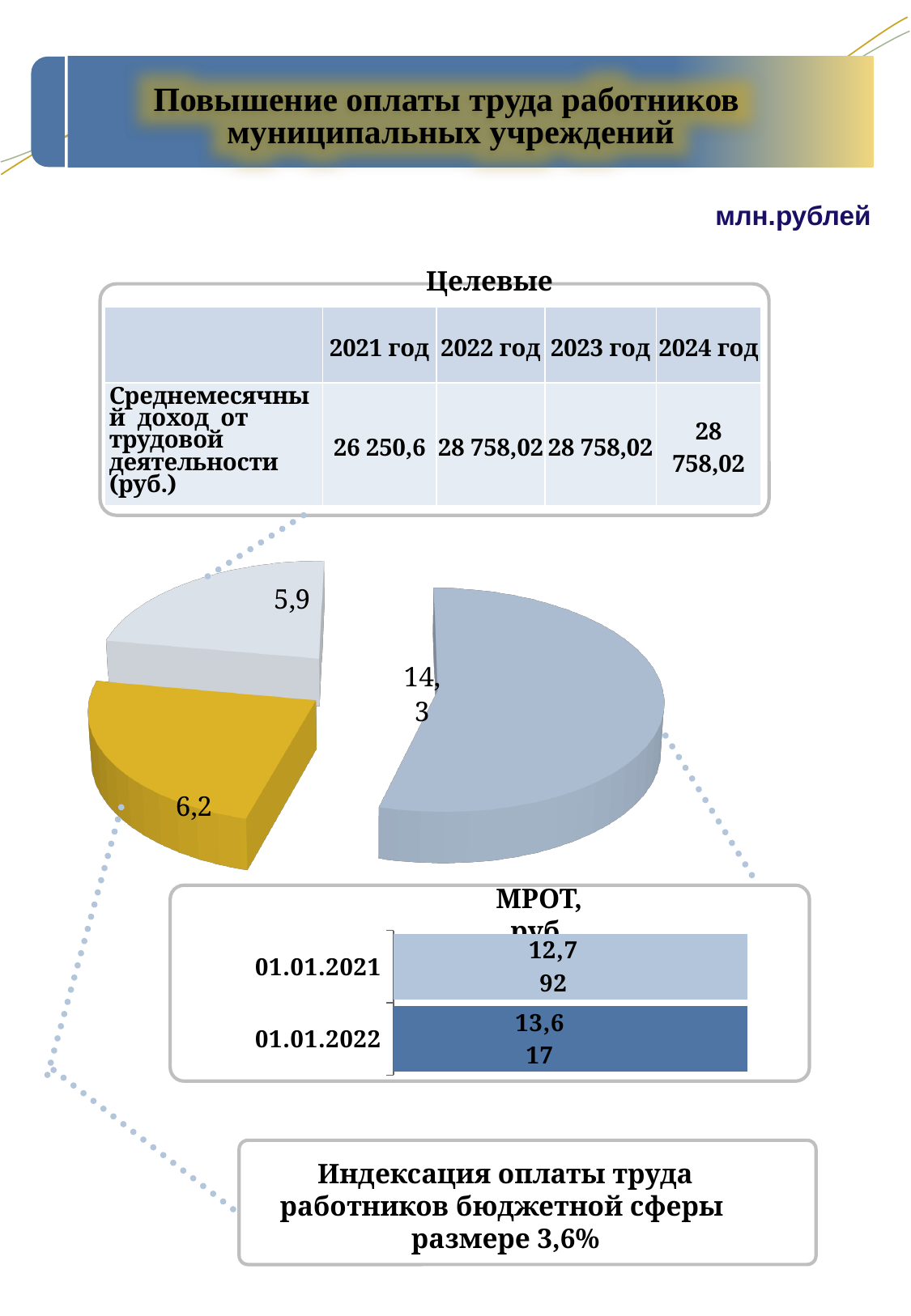
In the chart titled 'МРОТ, руб.', which date has the larger value: 01.01.2021 or 01.01.2022? 01.01.2022 In the pie chart, what is the sum of all three slice values? 26,4 What is the title of the bar chart at the bottom of the slide? МРОТ, руб. What kind of chart is the chart titled 'МРОТ, руб.'? bar chart How many slices does the pie chart have? 3 In the pie chart, which slice is larger: the yellow one or the light grey one? the yellow one (6,2) How many bars does the chart titled 'МРОТ, руб.' have? 2 What kind of chart is the chart in the middle of the slide with the yellow slice? pie chart In the pie chart, what is the difference between the largest slice (14,3) and the smallest slice (5,9)? 8,4 In the pie chart, what value is shown on the yellow slice? 6,2 In the pie chart, what is the value of the largest slice? 14,3 In the pie chart, what is the value of the smallest slice? 5,9